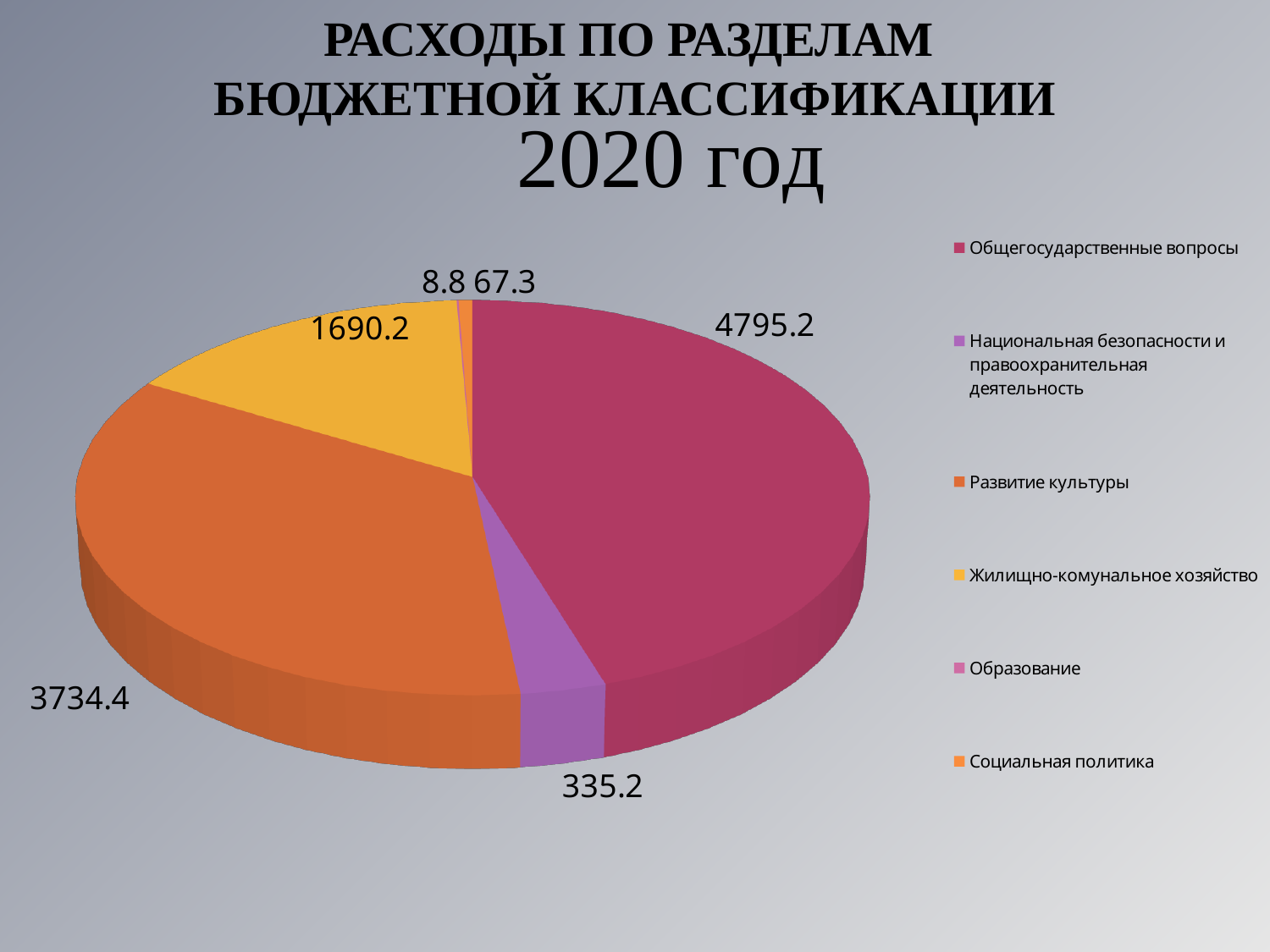
What is the value for Жилищно-комунальное хозяйство? 1690.2 What year does the chart title refer to? 2020 год Which is larger, the value for Жилищно-комунальное хозяйство or the value for Национальная безопасности и правоохранительная деятельность? Жилищно-комунальное хозяйство What is the value for Общегосударственные вопросы? 4795.2 Which category has the smallest slice of the pie? Образование What is the value for Национальная безопасности и правоохранительная деятельность? 335.2 What is the value for Развитие культуры? 3734.4 What is the difference between the values for Общегосударственные вопросы and Развитие культуры? 1060.8 Which category has the largest slice of the pie? Общегосударственные вопросы How many categories does the legend list? 6 What is the value for Образование? 8.8 What type of chart is shown on the slide? pie chart